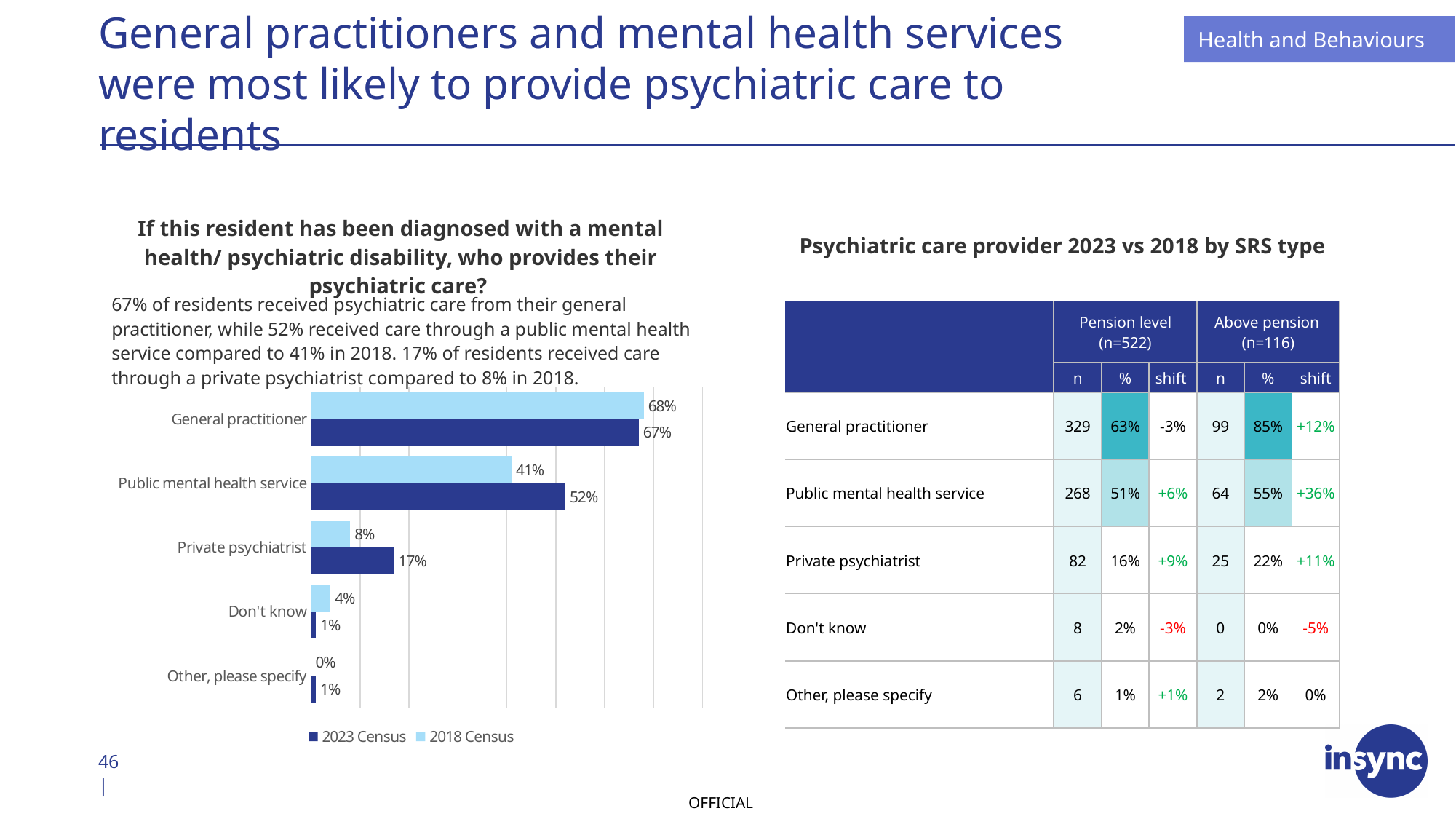
What is the difference between the 2023 Census and 2018 Census values for Private psychiatrist? 9% How many categories are shown in the bar chart? 5 Which category has the lowest 2018 Census value? Other, please specify What is the 2023 Census value for General practitioner? 67% What is the 2023 Census value for Private psychiatrist? 17% What type of chart is shown on the slide? Bar chart How many series does the chart legend list? 2 What is the difference between the 2023 Census and 2018 Census values for Public mental health service? 11% Which is larger for Don't know: the 2023 Census value or the 2018 Census value? 2018 Census What is the 2018 Census value for Don't know? 4% Which category has the highest 2023 Census value? General practitioner What is the 2018 Census value for Public mental health service? 41%